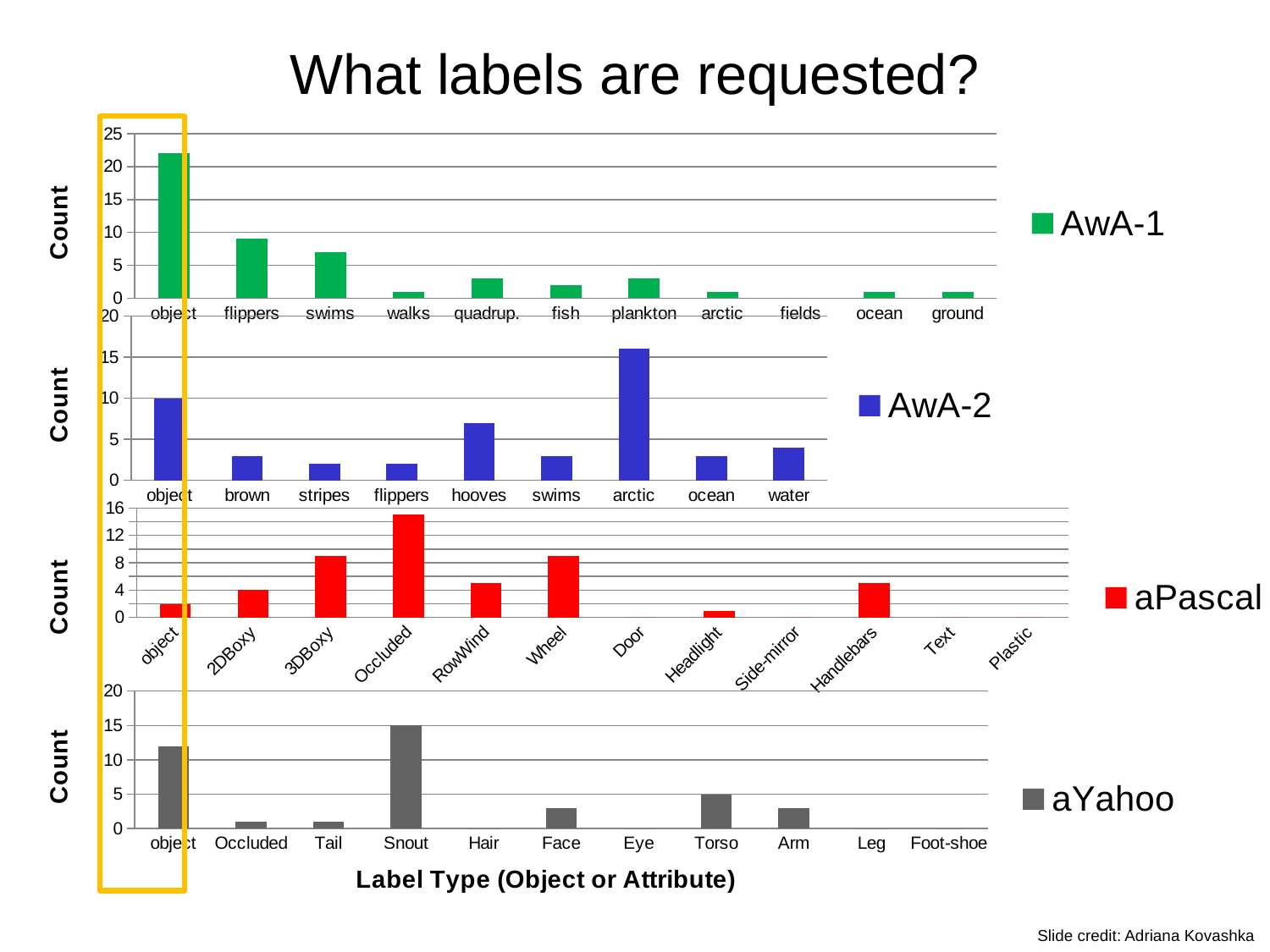
In the AwA-1 chart, which has a larger count, "flippers" or "swims"? flippers How many label types are shown on the x axis of the AwA-2 chart? 9 In the aYahoo chart, what is the count for "Snout"? 15 What kind of chart is the aYahoo chart? bar chart In the AwA-2 chart, which label type has the highest count? arctic In the AwA-2 chart, what is the count for "object"? 10 How many label types are shown on the x axis of the aPascal chart? 12 In the aYahoo chart, is the count for "object" greater or less than 10? greater In the AwA-1 chart, which label type has the highest count? object In the aPascal chart, what is the count for "2DBoxy"? 4 In the AwA-1 chart, is the count for "object" greater or less than 20? greater In the aPascal chart, which label type has the highest count? Occluded